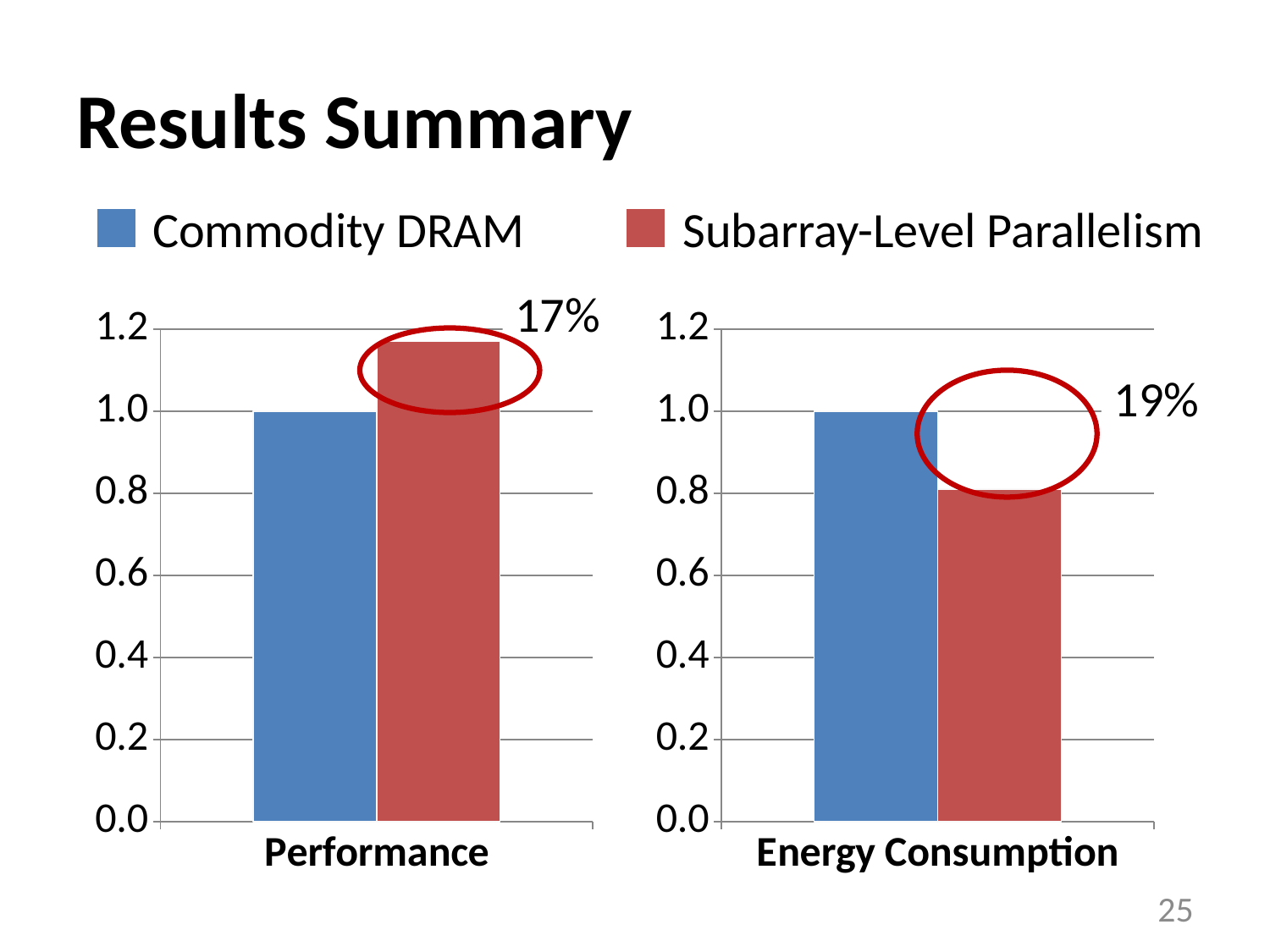
In the Energy Consumption chart, which is larger, Commodity DRAM or Subarray-Level Parallelism? Commodity DRAM How many series does the legend list? 2 In the Performance chart, is the value for Subarray-Level Parallelism greater or less than 1.0? greater What kind of chart is the Performance chart on the left? bar chart Which colour represents Subarray-Level Parallelism in the legend? red In the Energy Consumption chart, is the value for Subarray-Level Parallelism greater or less than 1.0? less In the Energy Consumption chart, is the value for Subarray-Level Parallelism greater or less than 0.6? greater In the Performance chart, which series has the higher bar? Subarray-Level Parallelism In the Energy Consumption chart, what is the value for Commodity DRAM? 1.0 In the Performance chart, what is the value for Commodity DRAM? 1.0 What percentage is annotated next to the circled bar in the Performance chart? 17% In the Energy Consumption chart, which series has the lower bar? Subarray-Level Parallelism